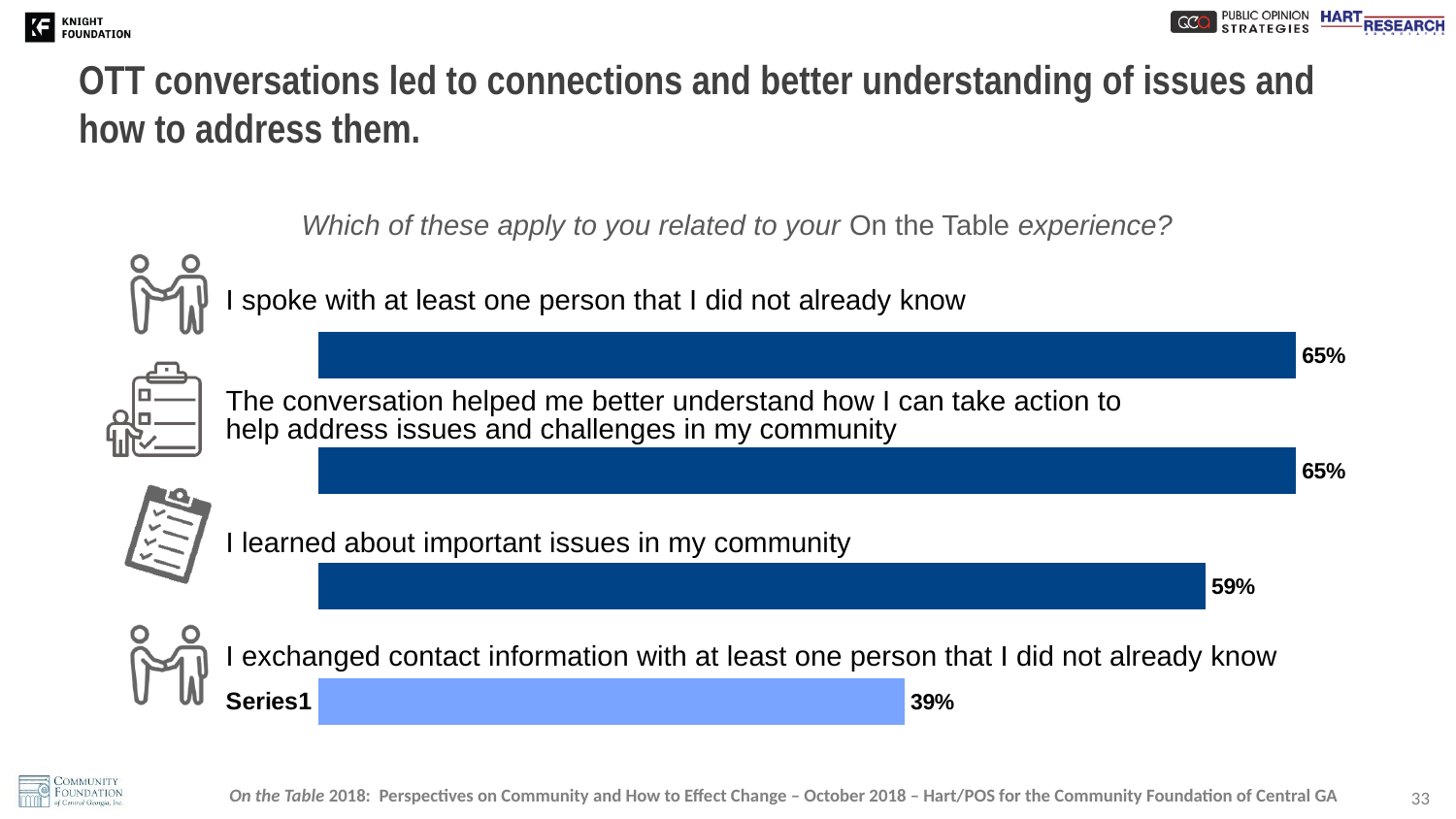
Which bar on the chart is shown in a lighter blue colour than the others? I exchanged contact information with at least one person that I did not already know What value is shown for "The conversation helped me better understand how I can take action to help address issues and challenges in my community"? 65% How many items (bars) are shown on the chart? 4 Which is larger: the value for "I learned about important issues in my community" or the value for "I exchanged contact information with at least one person that I did not already know"? I learned about important issues in my community What is the difference in percentage points between "I spoke with at least one person that I did not already know" and "I exchanged contact information with at least one person that I did not already know"? 26 percentage points What is the difference in percentage points between "I learned about important issues in my community" and "I exchanged contact information with at least one person that I did not already know"? 20 percentage points What percentage of respondents said they learned about important issues in their community? 59% What percentage of respondents said they spoke with at least one person that they did not already know? 65% Which item has the lowest percentage on the chart? I exchanged contact information with at least one person that I did not already know What percentage of respondents said they exchanged contact information with at least one person that they did not already know? 39% What type of chart is shown on the slide? Bar chart What survey question is the chart based on? Which of these apply to you related to your On the Table experience?